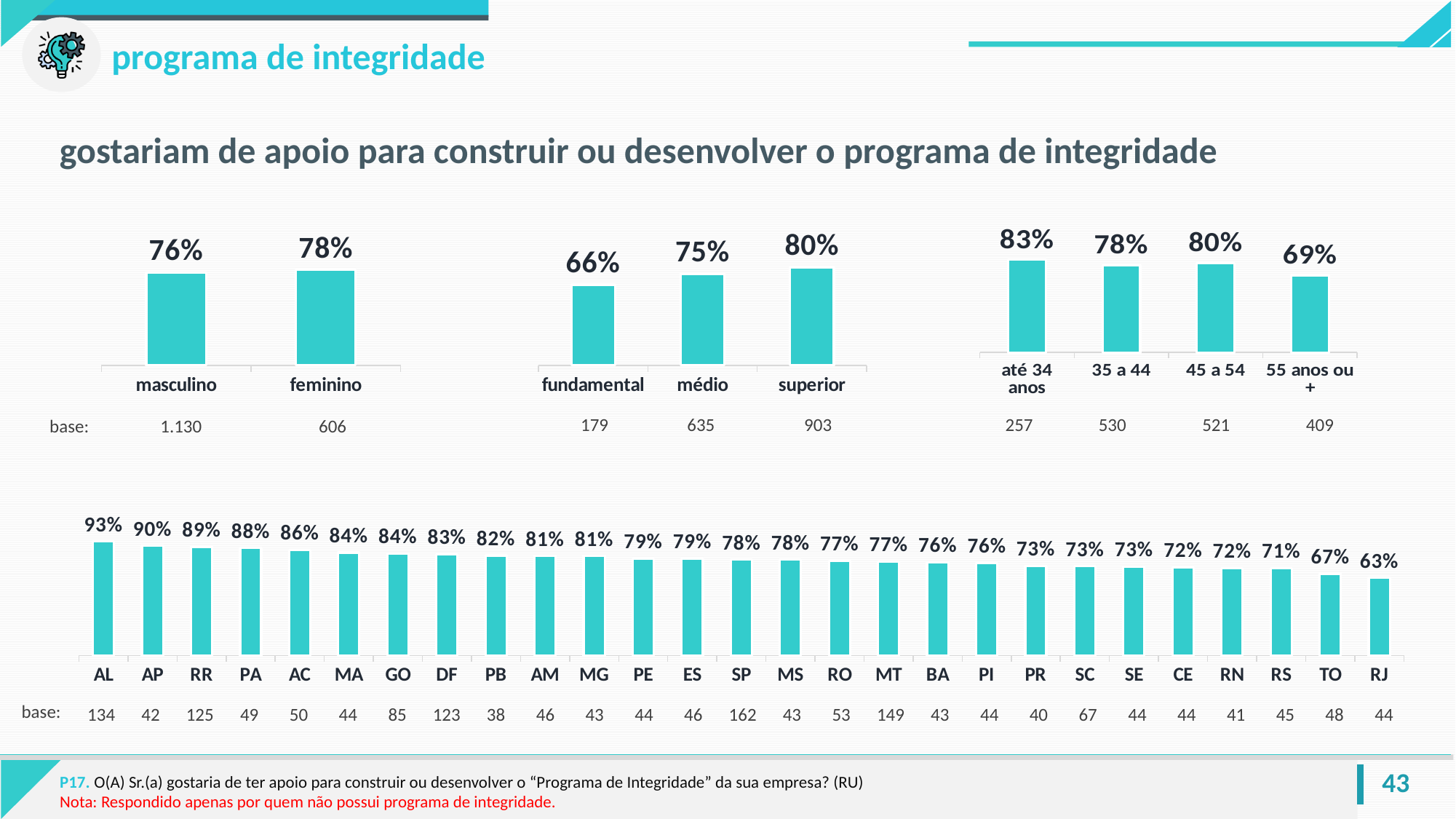
In the gender chart at the top left, what is the value for feminino? 78% In the state chart at the bottom, what is the value for SP? 78% In the state chart at the bottom, which state has the lowest value? RJ In the gender chart at the top left, which category has the lower value? masculino In the age chart at the top right, how many age groups are shown? 4 In the education chart at the top centre, what is the value for fundamental? 66% In the education chart at the top centre, which category has the highest value? superior In the age chart at the top right, which age group has the highest value? até 34 anos In the age chart at the top right, what is the value for 55 anos ou +? 69% What kind of chart is the state chart at the bottom of the slide? bar chart In the education chart at the top centre, what is the difference between superior and fundamental? 14 percentage points In the state chart at the bottom, which is larger, the value for GO or the value for TO? GO